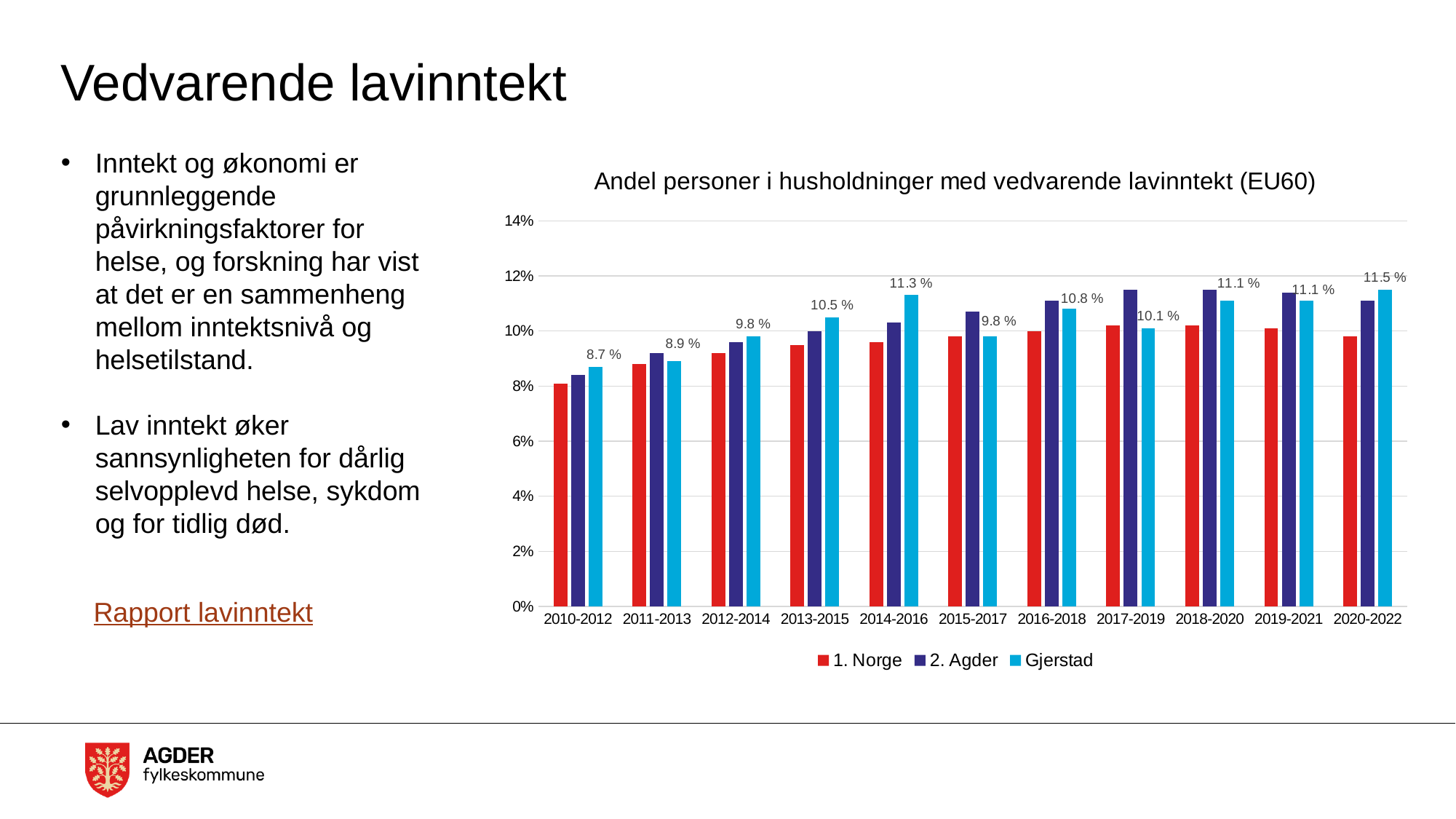
What is the difference between the Gjerstad value in 2020-2022 and in 2010-2012? 2.8 % Is the value for 1. Norge in 2010-2012 greater or less than 10%? less What is the value for Gjerstad in 2010-2012? 8.7 % In which period is the Gjerstad value highest? 2020-2022 How many periods are shown on the x axis? 11 What is the value for Gjerstad in 2014-2016? 11.3 % In which period is the Gjerstad value lowest? 2010-2012 What is the title of the chart? Andel personer i husholdninger med vedvarende lavinntekt (EU60) How many series does the legend list? 3 What is the value for Gjerstad in 2017-2019? 10.1 % What kind of chart is shown on the slide? bar chart Which is larger for Gjerstad: the value in 2014-2016 or in 2015-2017? 2014-2016